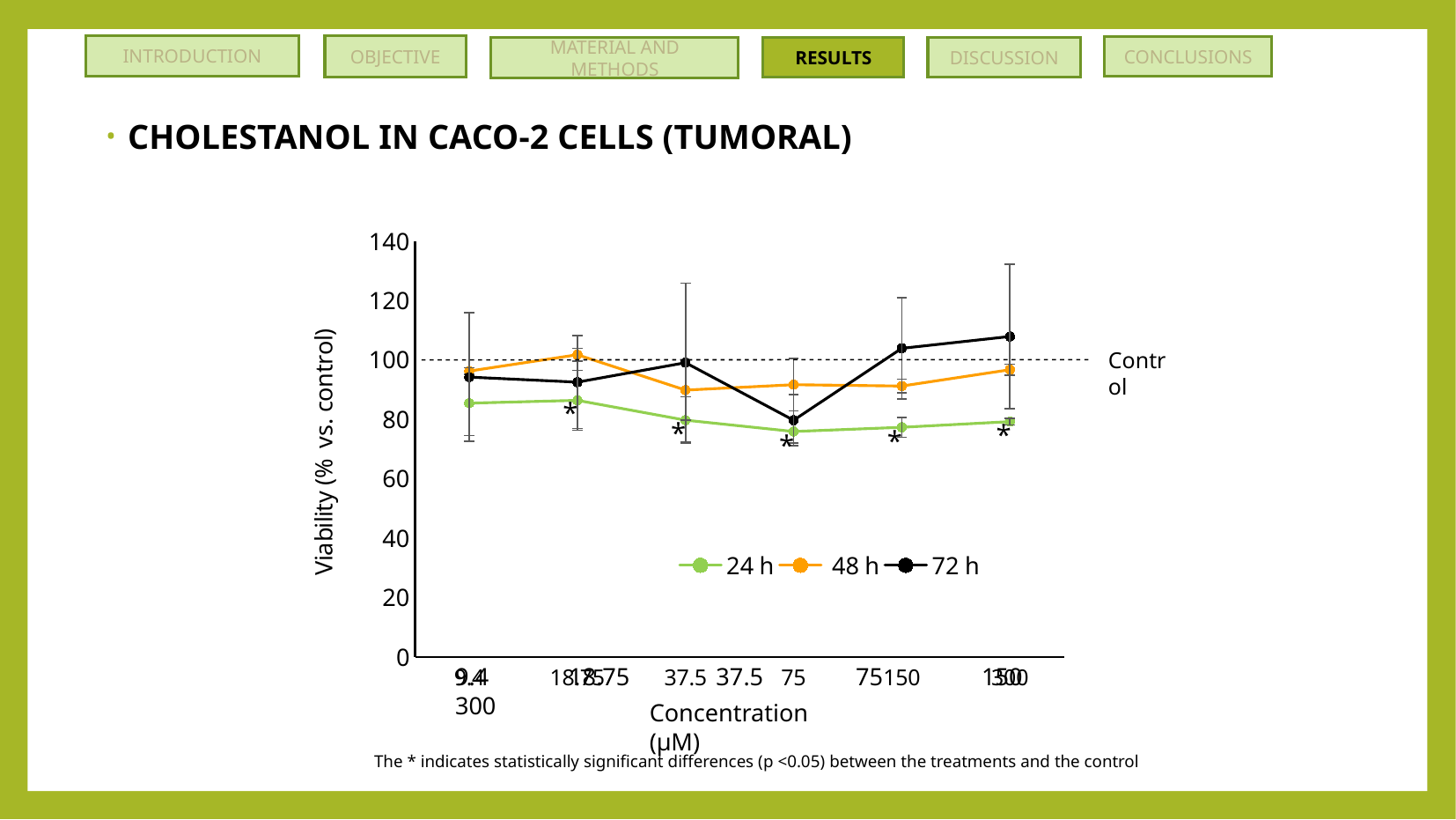
Is the value of the 24 h series at the rightmost concentration greater or less than 100? less Which series has the lowest values across the chart? 24 h Is the value of the 72 h series at the rightmost concentration greater or less than 100? greater How many series does the legend list? 3 What is the label of the y axis? Viability (% vs. control) How many data points does each series have along the x axis? 6 What does the dashed horizontal line at 100 represent? Control At the fourth concentration point, which series has the higher value, 48 h or 72 h? 48 h Is the value of the 72 h series at the fourth concentration point greater or less than 100? less At the rightmost concentration, which series has the higher value, 24 h or 72 h? 72 h What kind of chart is shown on the slide? line chart